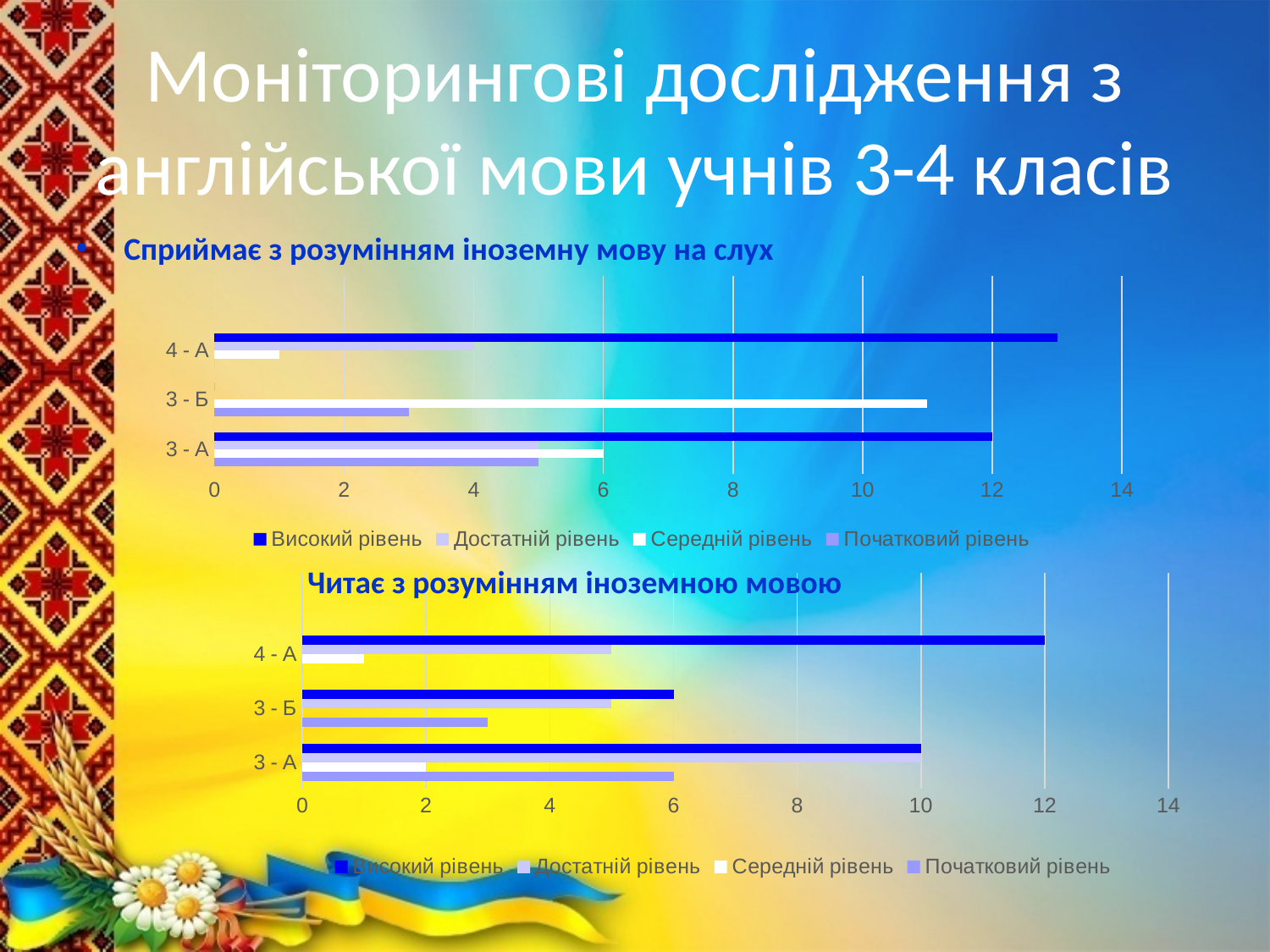
How many class categories are shown on the top chart "Сприймає з розумінням іноземну мову на слух"? 3 What kind of chart is the top chart titled "Сприймає з розумінням іноземну мову на слух"? bar chart In the top chart "Сприймає з розумінням іноземну мову на слух", which class has the highest value for Високий рівень? 4 - А In the bottom chart "Читає з розумінням іноземною мовою", which class has the lowest value for Високий рівень? 3 - Б In the bottom chart "Читає з розумінням іноземною мовою", is the Початковий рівень value for 3 - Б greater or less than 4? less In the top chart "Сприймає з розумінням іноземну мову на слух", is the Високий рівень value for 4 - А greater or less than 12? greater What is the title of the bottom chart on the slide? Читає з розумінням іноземною мовою How many series does the legend of the bottom chart "Читає з розумінням іноземною мовою" list? 4 In the top chart "Сприймає з розумінням іноземну мову на слух", is the Середній рівень value for 3 - Б greater or less than 10? greater In the top chart "Сприймає з розумінням іноземну мову на слух", which is larger for 3 - Б: Середній рівень or Початковий рівень? Середній рівень In the bottom chart "Читає з розумінням іноземною мовою", which class has the highest value for Високий рівень? 4 - А